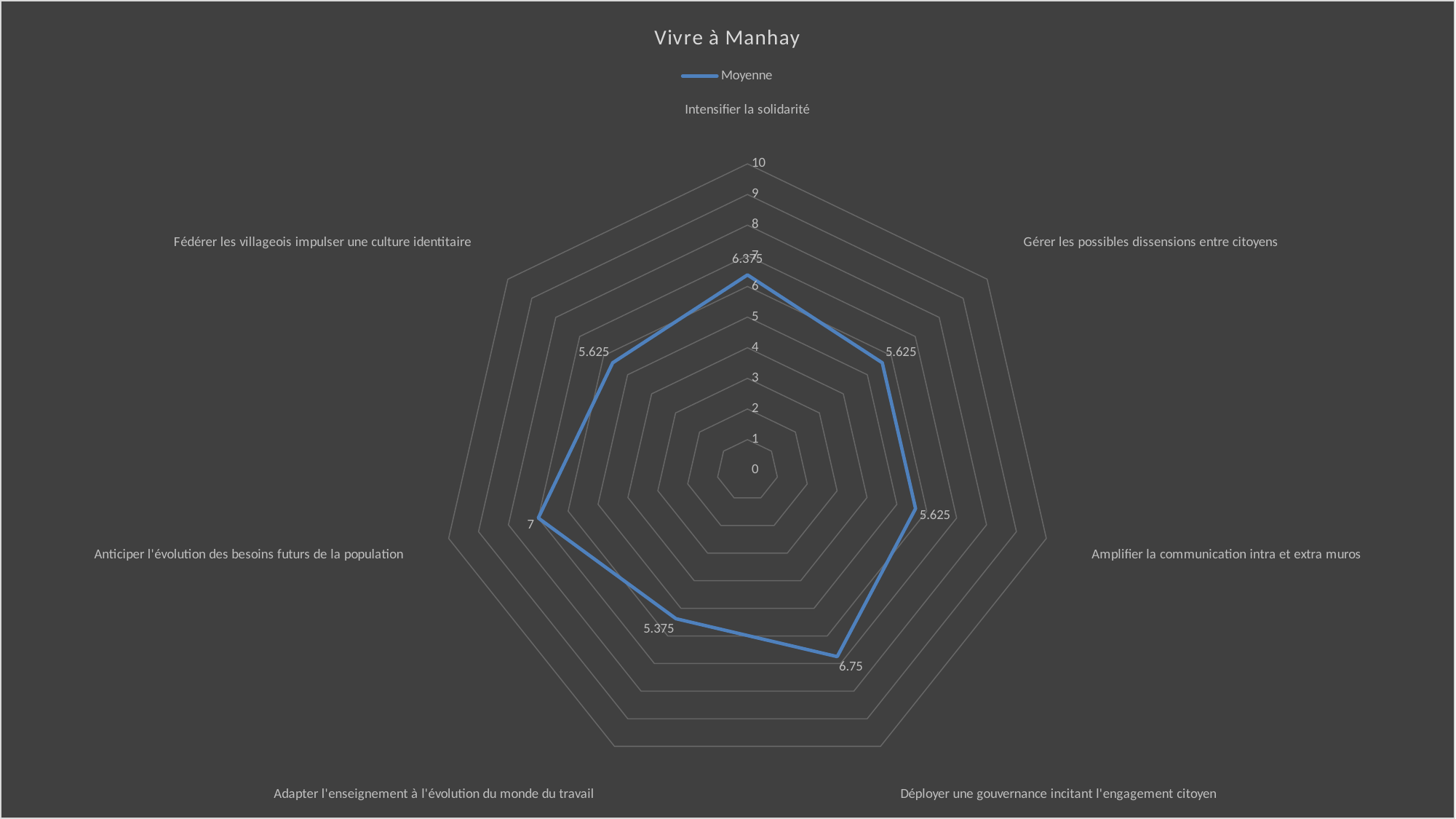
What is the value for 'Intensifier la solidarité'? 6.375 How many series does the legend list? 1 Which category has the highest value? Anticiper l'évolution des besoins futurs de la population Which is larger: the value for 'Déployer une gouvernance incitant l'engagement citoyen' or the value for 'Intensifier la solidarité'? Déployer une gouvernance incitant l'engagement citoyen Which category has the lowest value? Adapter l'enseignement à l'évolution du monde du travail What is the difference between the value for 'Anticiper l'évolution des besoins futurs de la population' and the value for 'Adapter l'enseignement à l'évolution du monde du travail'? 1.625 What is the name of the series shown in the legend? Moyenne What is the title of the chart? Vivre à Manhay What is the value for 'Adapter l'enseignement à l'évolution du monde du travail'? 5.375 What type of chart is shown on the slide? Radar chart What is the value for 'Déployer une gouvernance incitant l'engagement citoyen'? 6.75 How many categories are plotted on the radar chart? 7